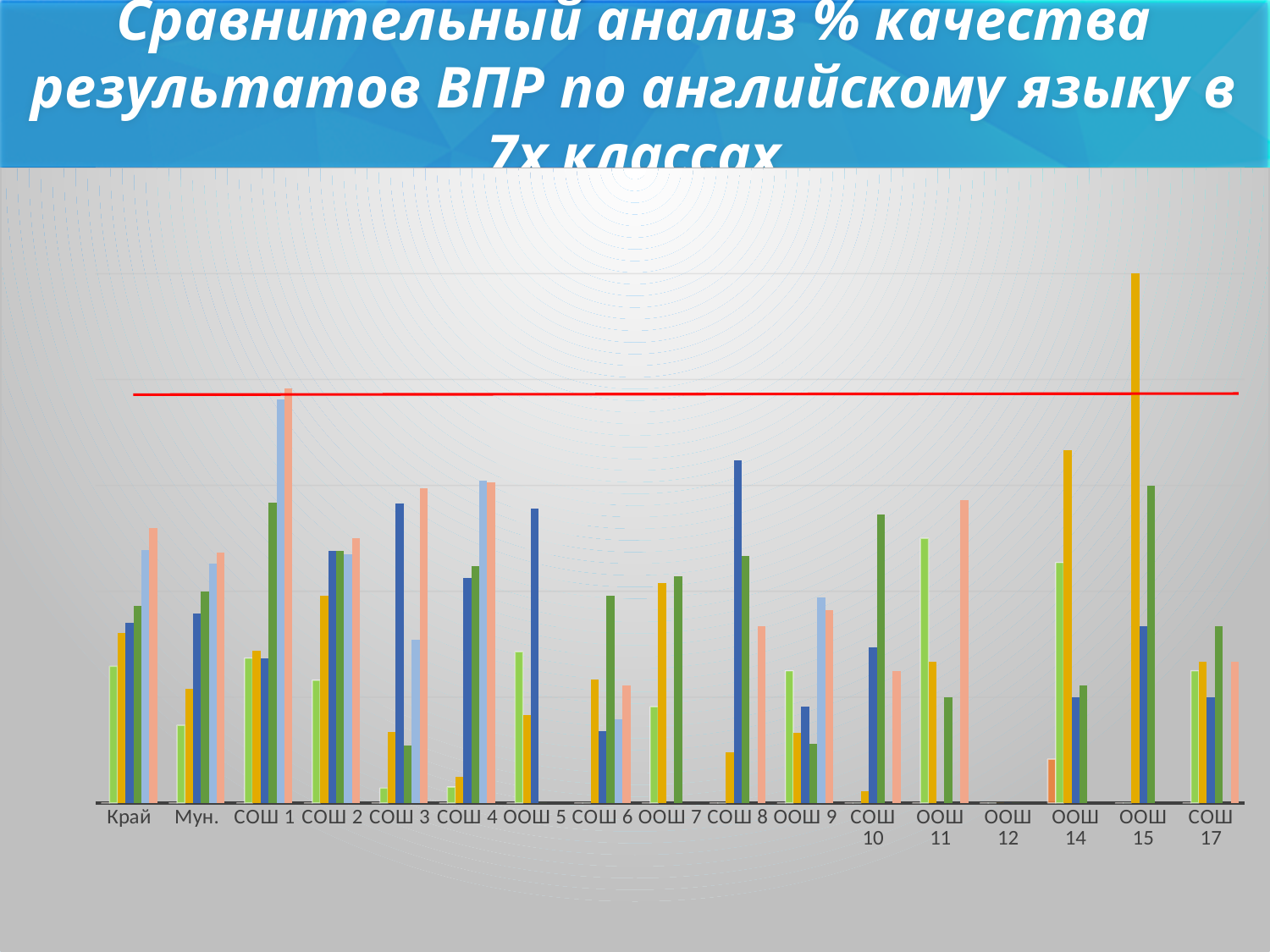
For the category ООШ 11, which coloured bar is the tallest? salmon How many categories are labelled along the x axis of the chart? 17 Which category has the tallest bar in the whole chart? ООШ 15 How many bars are plotted for the category ООШ 15? 3 For the category СОШ 8, which is taller: the dark blue bar or the gold bar? dark blue How many bars are plotted for the category ООШ 7? 3 For the category ООШ 14, which is taller: the gold bar or the dark blue bar? gold Which category on the x axis has no bars plotted at all? ООШ 12 For the category Край, which is taller: the salmon bar or the light green bar? salmon What kind of chart is shown on the slide? bar chart What colour is the horizontal line drawn across the chart? red